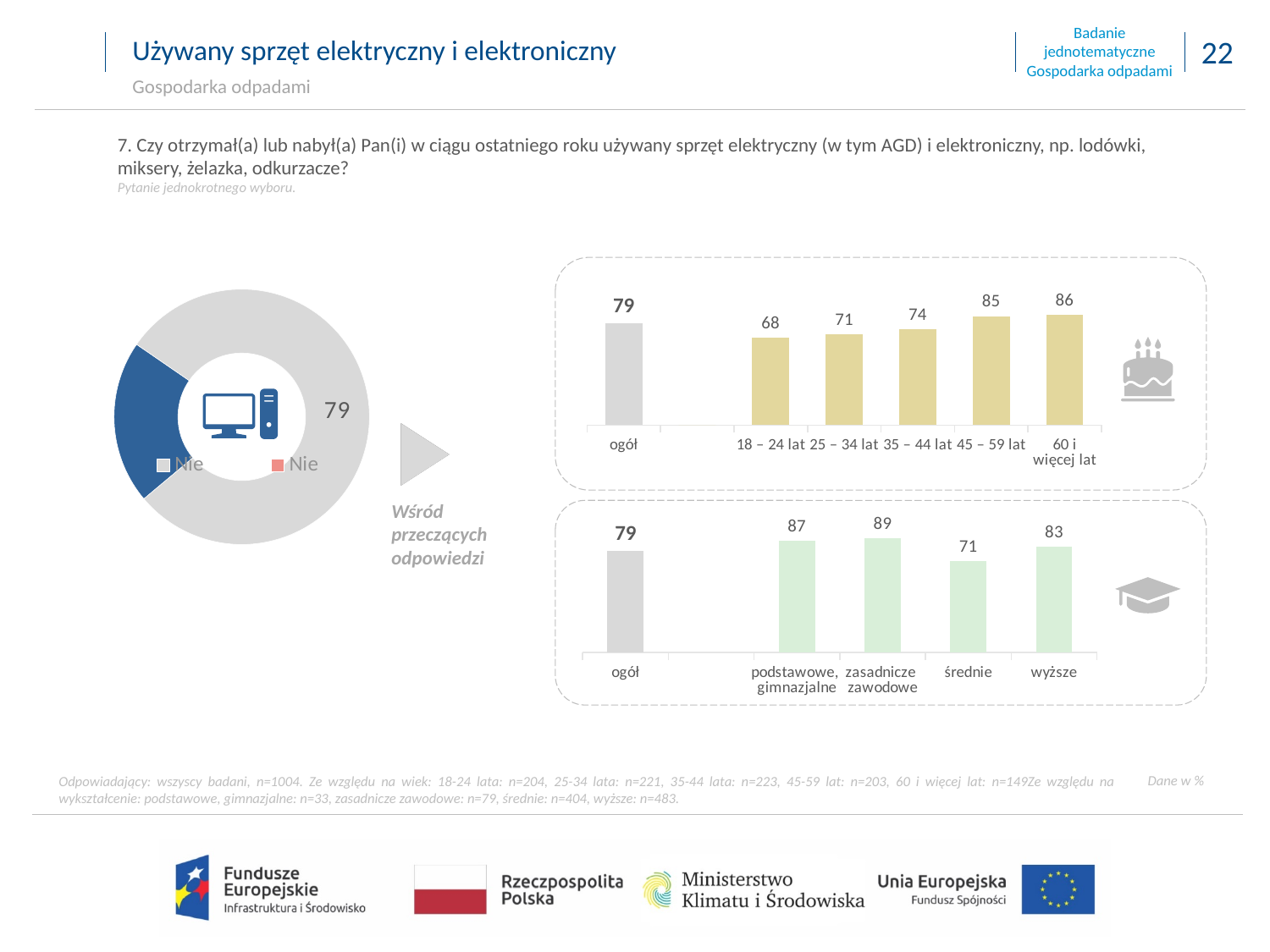
In the top-right bar chart (by age), what is the value for 18 – 24 lat? 68 In the top-right bar chart (by age), what is the value for 45 – 59 lat? 85 In the bottom-right bar chart (by education), how many bars are shown? 5 In the top-right bar chart (by age), do the values rise or fall from 18 – 24 lat to 60 i więcej lat? rise What type of chart is shown on the left side of the slide? donut chart In the bottom-right bar chart (by education), what is the value for zasadnicze zawodowe? 89 In the bottom-right bar chart (by education), which education group has the lowest value? średnie In the bottom-right bar chart (by education), what is the value for średnie? 71 In the top-right bar chart (by age), which age group has the highest value? 60 i więcej lat In the top-right bar chart (by age), which age group has the lowest value? 18 – 24 lat In the bottom-right bar chart (by education), which is larger, the value for wyższe or the value for ogół? wyższe In the top-right bar chart (by age), what is the difference between the values for 60 i więcej lat and 18 – 24 lat? 18